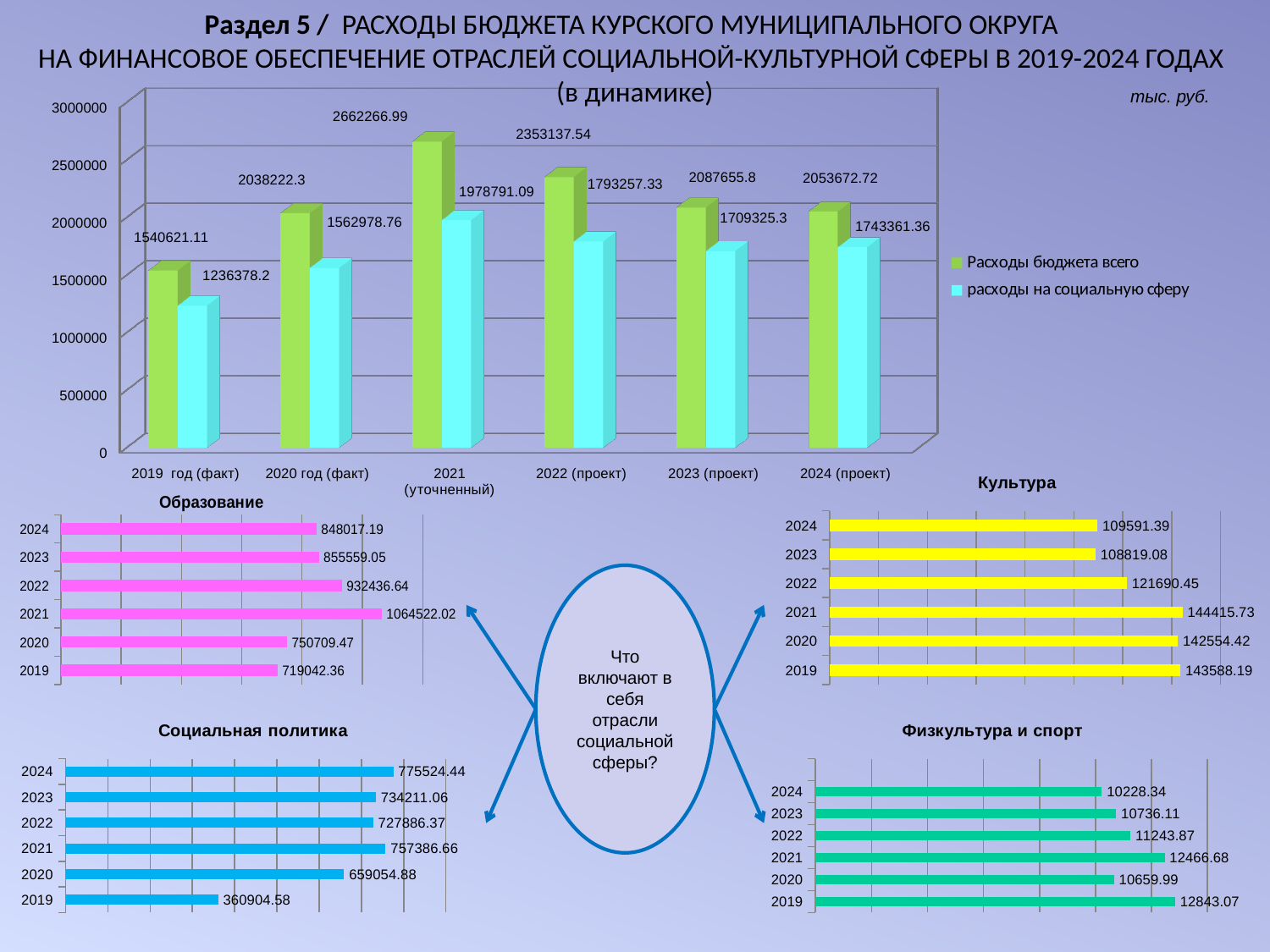
In the top chart, how many series does the legend list? 2 In the 'Социальная политика' chart, which is larger: the value for 2024 or the value for 2020? 2024 In the top chart, which year has the highest value for 'Расходы бюджета всего'? 2021 (уточненный) In the 'Культура' chart, what is the value for 2022? 121690.45 In the 'Образование' chart, what is the value for 2021? 1064522.02 In the top chart, what is the value of 'расходы на социальную сферу' for 2019 год (факт)? 1236378.2 In the top chart, what is the value of 'Расходы бюджета всего' for 2021 (уточненный)? 2662266.99 In the 'Образование' chart, which year has the lowest value? 2019 In the 'Физкультура и спорт' chart, what is the value for 2019? 12843.07 How many years are shown in the 'Физкультура и спорт' chart? 6 In the 'Социальная политика' chart, which year has the lowest value? 2019 In the top chart, what is the difference between 'Расходы бюджета всего' and 'расходы на социальную сферу' in 2021 (уточненный)? 683475.9